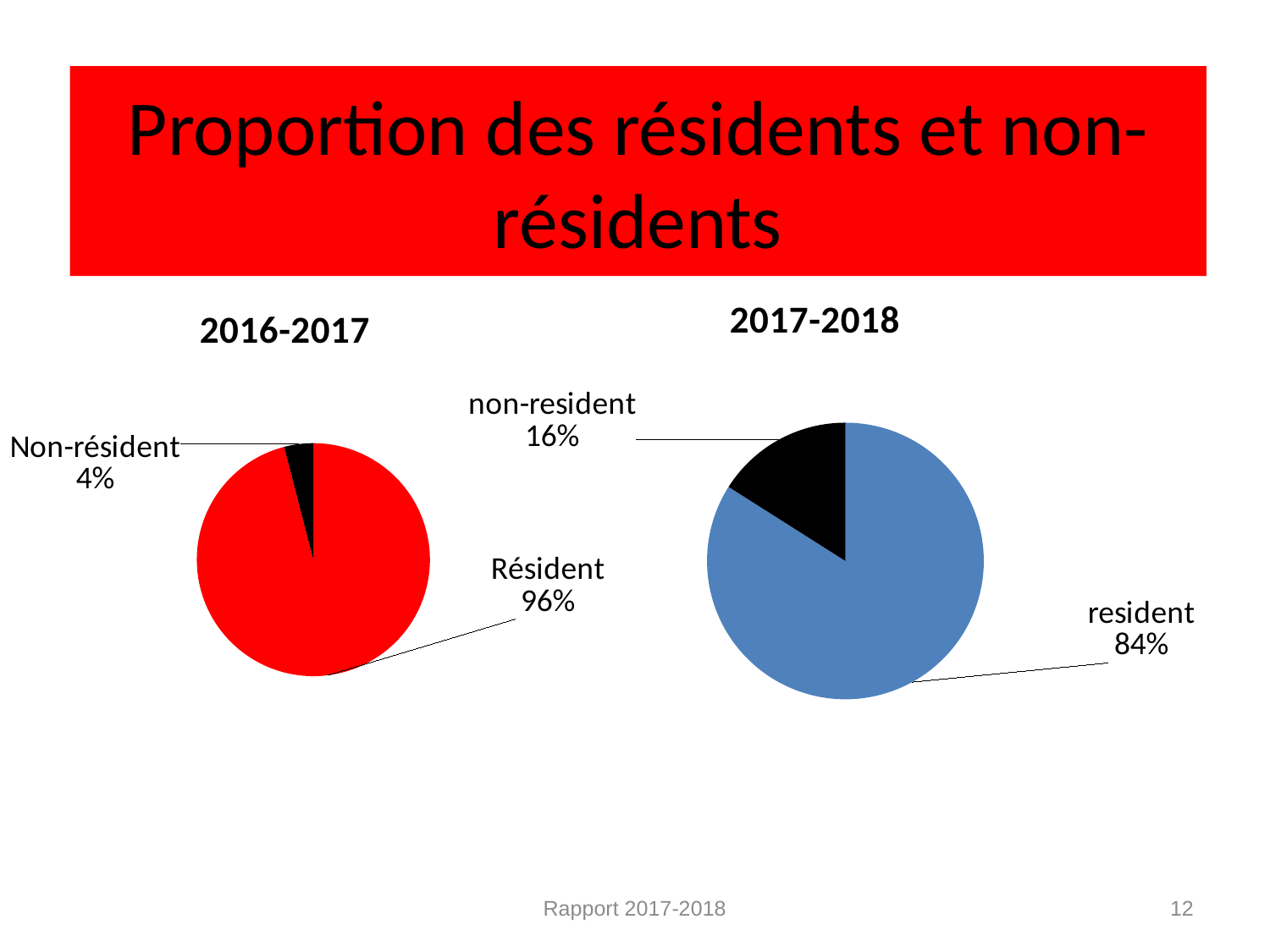
Which is larger: the non-resident share in 2017-2018 or the Non-résident share in 2016-2017? non-resident share in 2017-2018 In the 2017-2018 chart, what share is labelled for non-resident? 16% In the 2017-2018 chart, what is the difference between the resident and non-resident shares? 68% In the 2017-2018 chart, which slice is the smallest? non-resident In the 2017-2018 chart, what share is labelled for resident? 84% What kind of chart is the 2017-2018 chart? Pie chart In the 2016-2017 chart, what is the difference between the Résident and Non-résident shares? 92% In the 2016-2017 chart, what share is labelled for Résident? 96% In the 2016-2017 chart, which slice is the largest? Résident In the 2016-2017 chart, what share is labelled for Non-résident? 4% How many slices does the 2016-2017 chart have? 2 What colour is the Résident slice in the 2016-2017 chart? Red